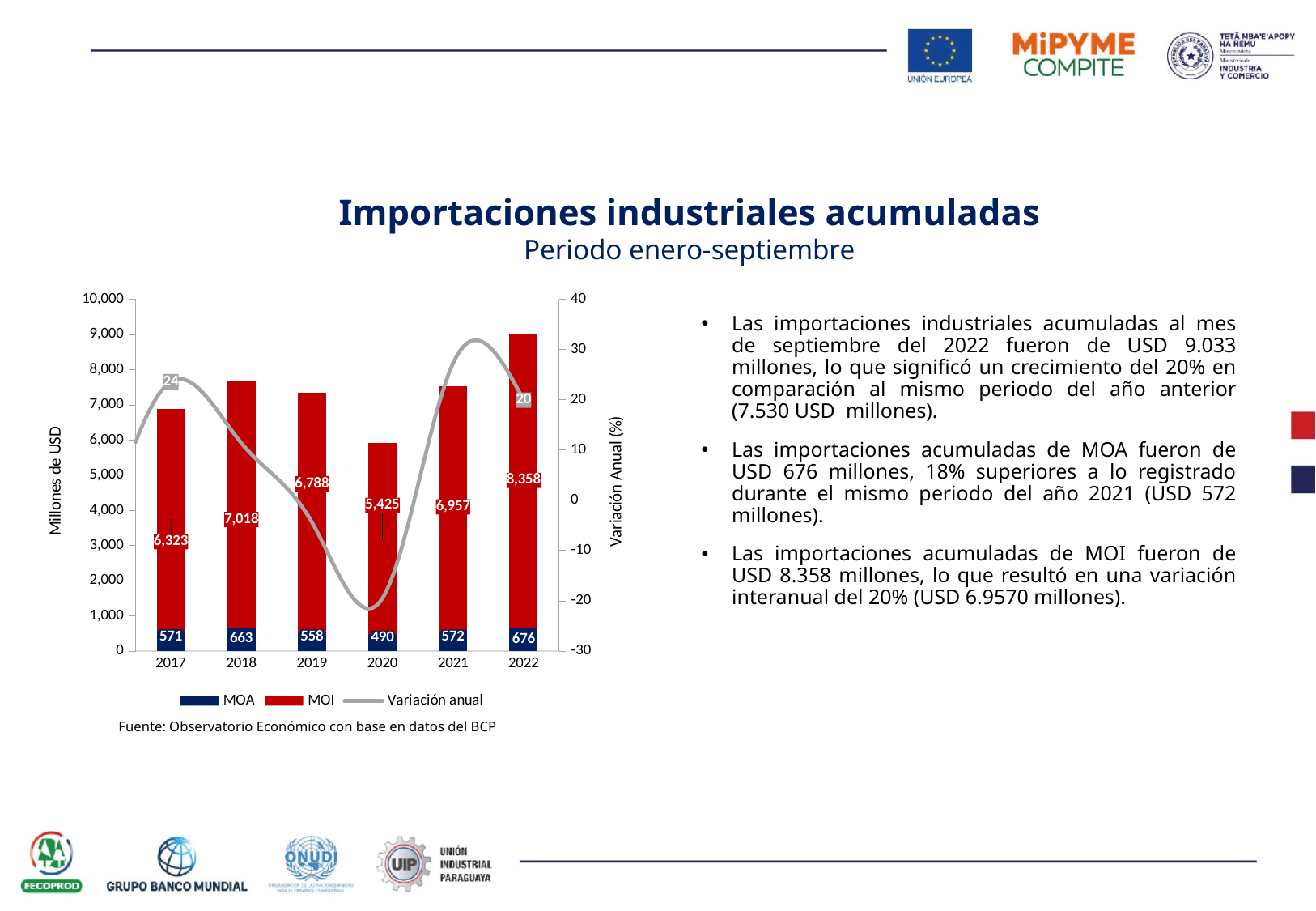
What is the value of Variación anual in 2017? 24 What kind of chart is shown on the slide? Stacked bar chart with a line series Which year has the larger MOA value, 2018 or 2019? 2018 How many series does the legend list? 3 In which year is the MOI value highest? 2022 Is the Variación anual value for 2020 greater or less than -10? less How many years are shown on the x axis? 6 What is the value for MOI in 2020? 5,425 What is the total of the stacked bar for 2020 (MOA plus MOI)? 5,915 In which year is the MOA value lowest? 2020 What is the difference between the MOI values for 2022 and 2021? 1,401 What is the value for MOA in 2022? 676